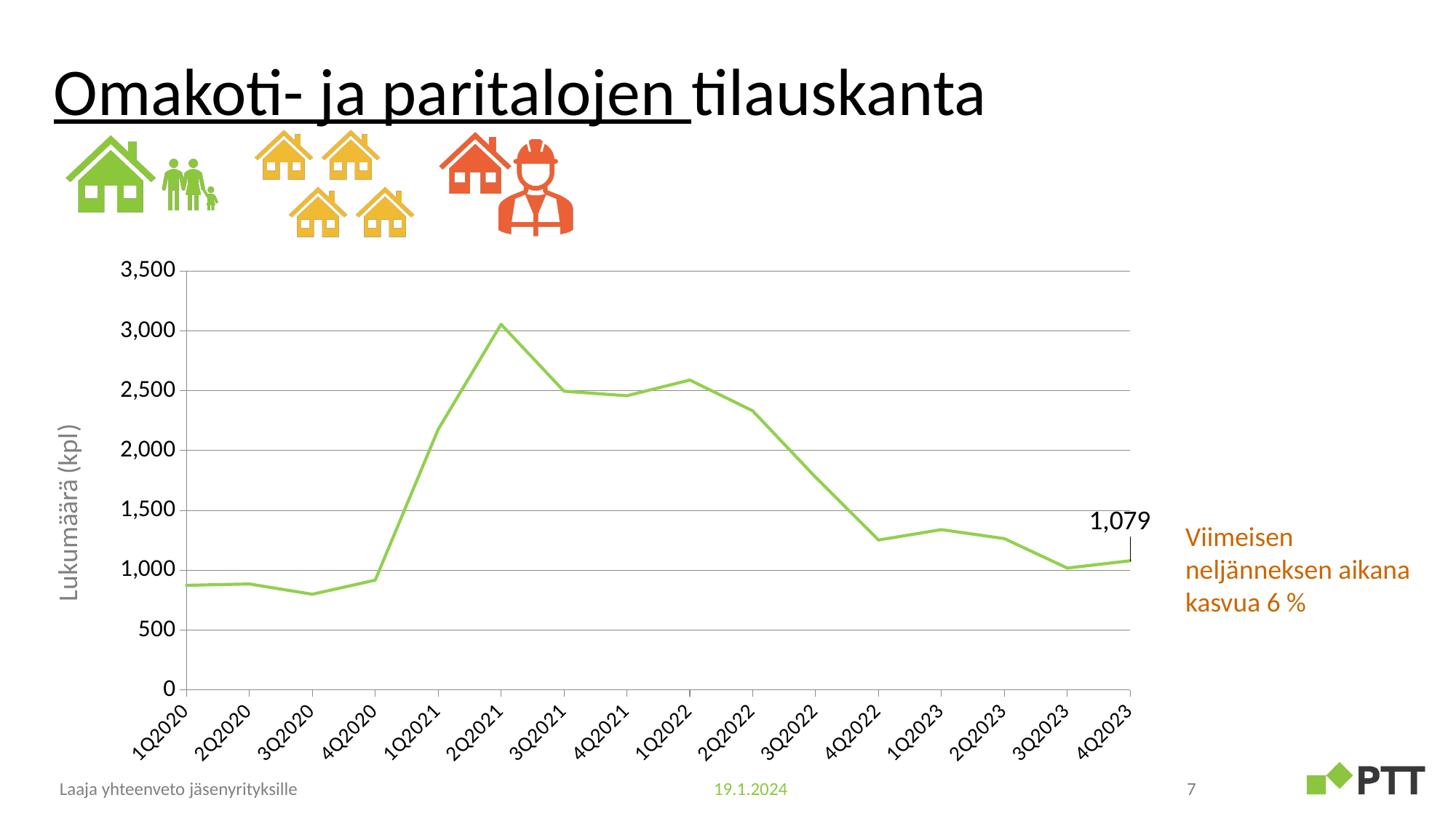
Is the value for 3Q2020 greater or less than 1,000? less What is the value for 4Q2023? 1,079 Which is larger, the value for 4Q2020 or the value for 1Q2021? 1Q2021 How many quarters are plotted on the x axis? 16 What kind of chart is shown on the slide? line chart Is the value for 1Q2022 greater or less than 2,000? greater Which quarter has the lowest value? 3Q2020 Is the value for 2Q2021 greater or less than 2,500? greater Which is larger, the value for 1Q2023 or the value for 3Q2023? 1Q2023 Which quarter has the highest value? 2Q2021 Do the values rise or fall from 2Q2021 to 4Q2022? fall